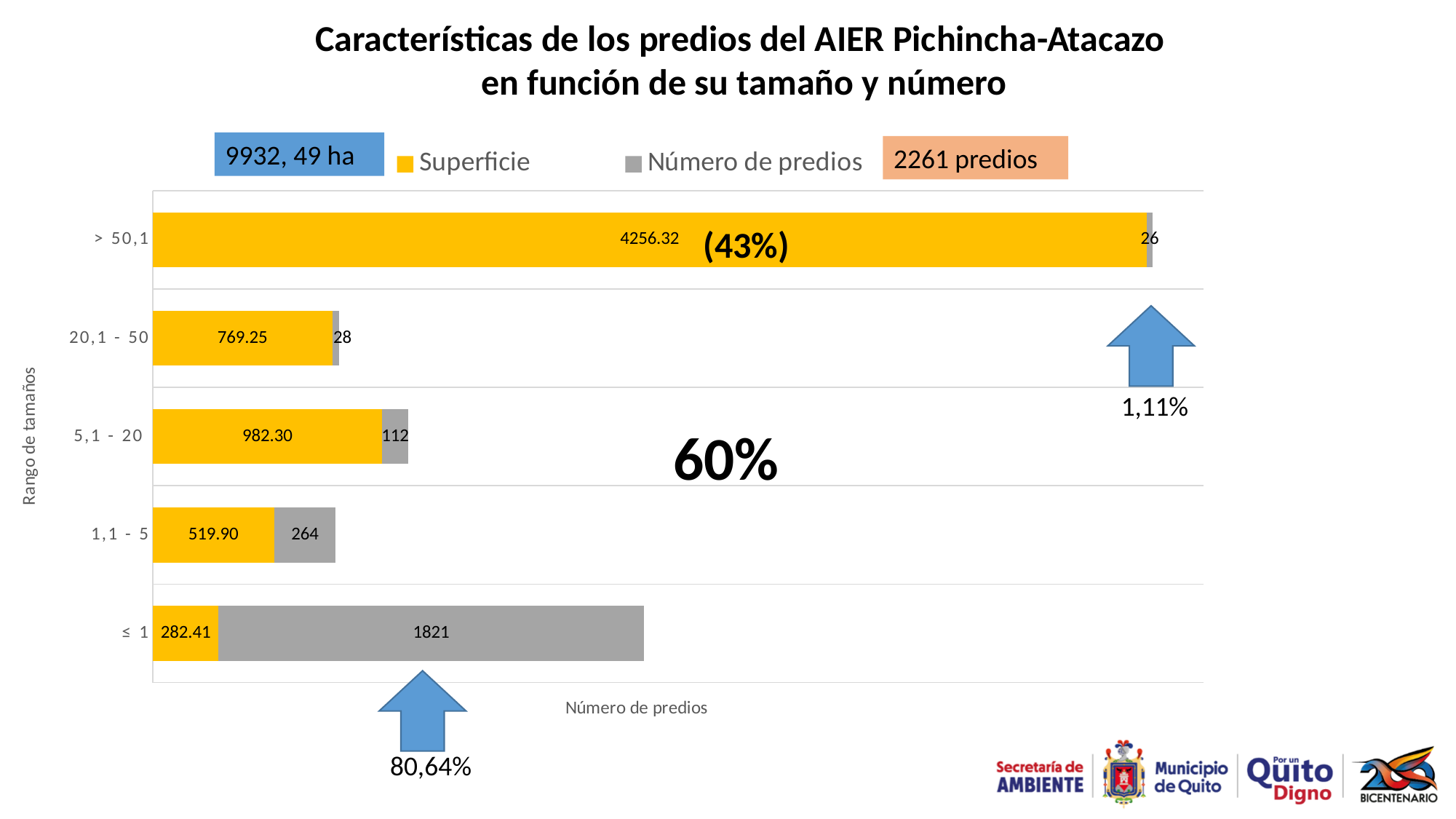
What is the difference in Número de predios between the ≤ 1 range and the 1,1 - 5 range? 1557 What type of chart is shown on the slide? bar chart How many size ranges (categories) are plotted on the chart? 5 Which size range has the lowest Superficie? ≤ 1 What is the Número de predios value for the ≤ 1 range? 1821 What are the two legend entries of the chart? Superficie and Número de predios Which has the larger Superficie: the 20,1 - 50 range or the 1,1 - 5 range? 20,1 - 50 What is the Número de predios value for the 1,1 - 5 range? 264 What is the Superficie value for the > 50,1 range? 4256.32 How many series does the legend list? 2 Which size range has the highest Número de predios? ≤ 1 What is the Superficie value for the 5,1 - 20 range? 982.30